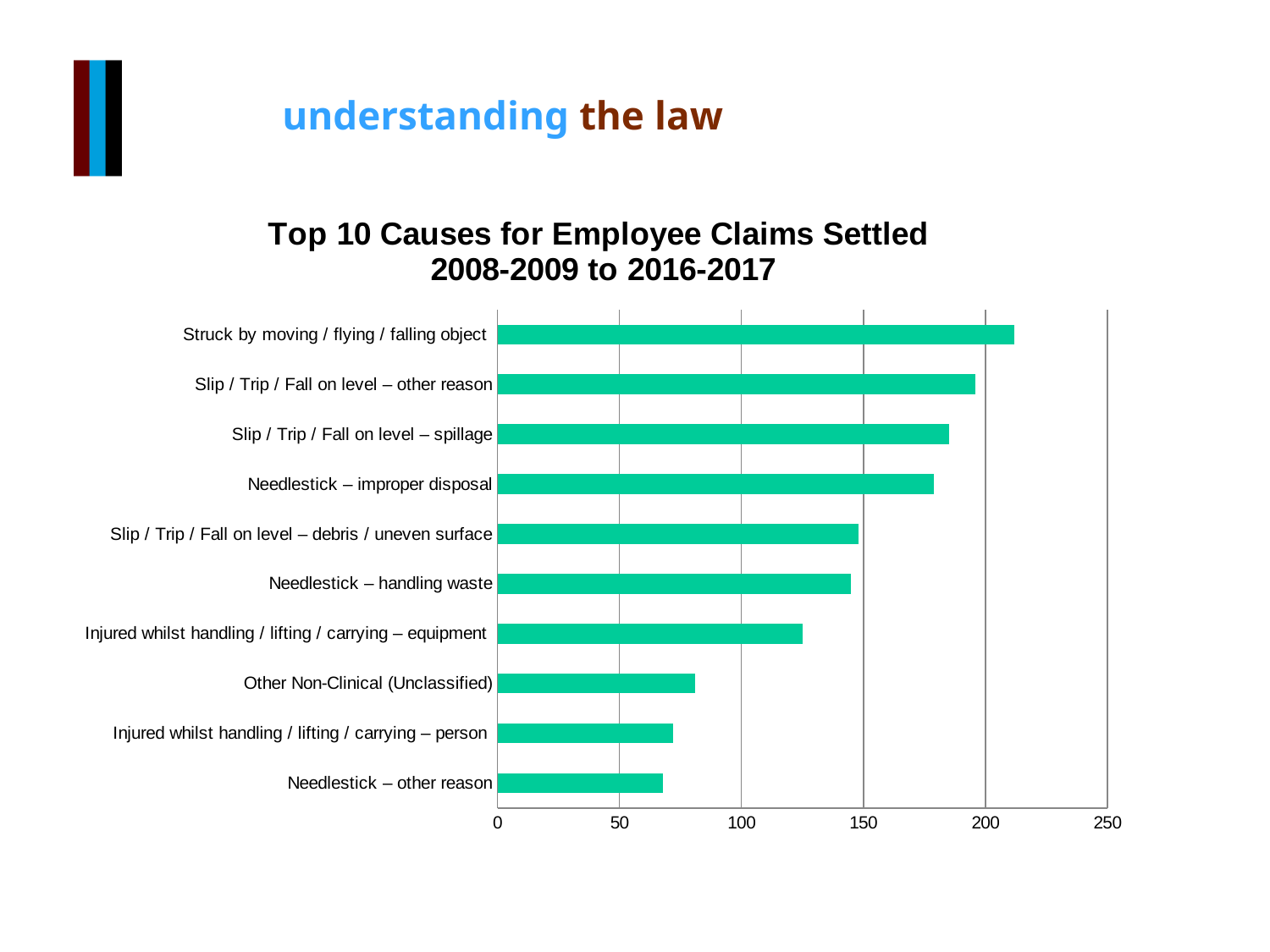
Is the value for Slip / Trip / Fall on level – spillage greater or less than 200? less Is the value for Needlestick – improper disposal greater or less than 150? greater Is the value for Struck by moving / flying / falling object greater or less than 200? greater What kind of chart is shown on the slide? Bar chart Which has more claims settled: Slip / Trip / Fall on level – spillage or Needlestick – handling waste? Slip / Trip / Fall on level – spillage Which cause has the lowest number of claims settled? Needlestick – other reason Which cause has the highest number of claims settled? Struck by moving / flying / falling object How many causes are listed in the chart? 10 What is the title of the chart? Top 10 Causes for Employee Claims Settled 2008-2009 to 2016-2017